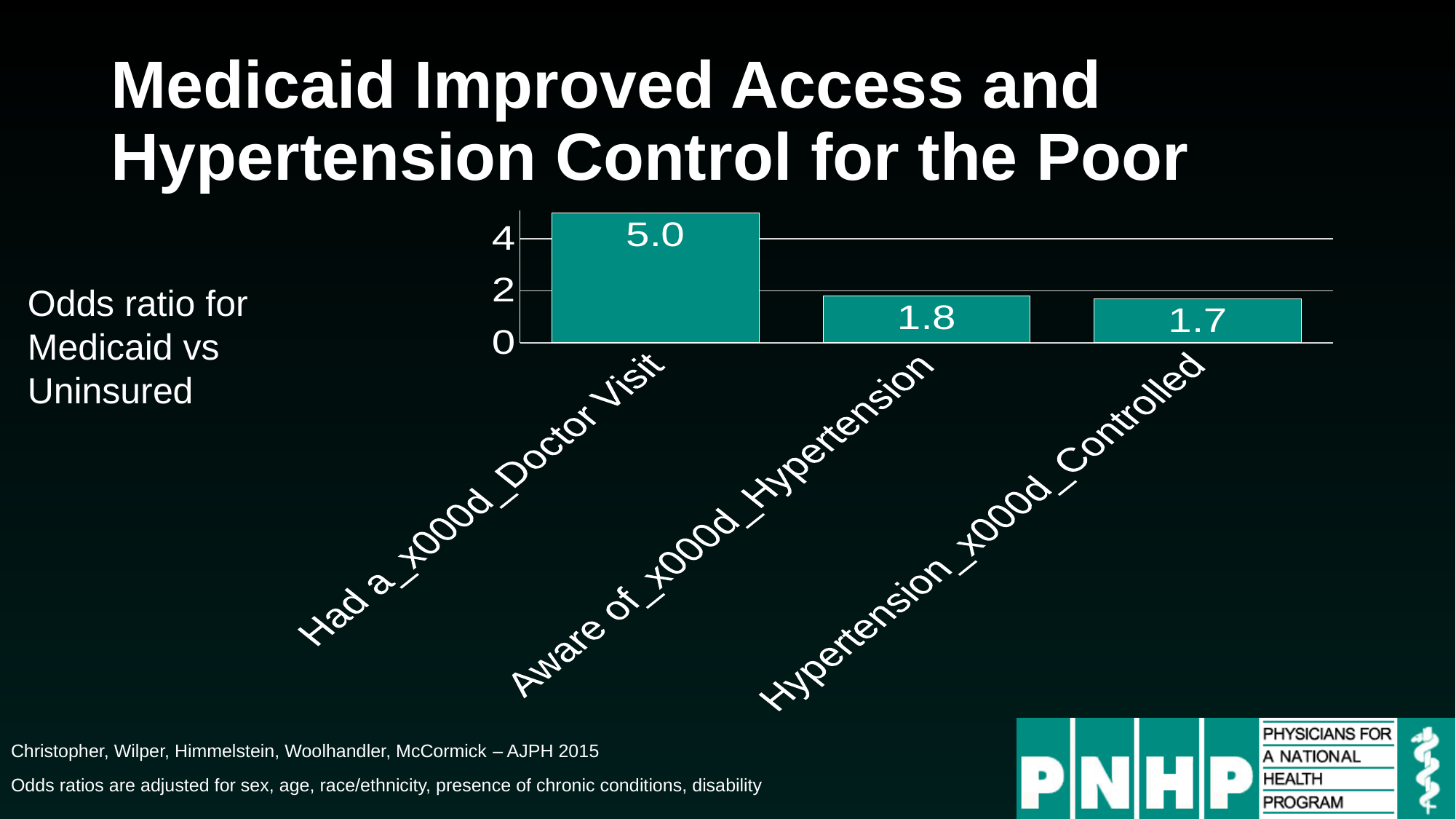
Which category has the highest odds ratio? Had a Doctor Visit What is the difference between the odds ratio for "Aware of Hypertension" and for "Hypertension Controlled"? 0.1 What kind of chart is shown on the slide? Bar chart Which category has the lowest odds ratio? Hypertension Controlled What is the difference between the odds ratio for "Had a Doctor Visit" and for "Aware of Hypertension"? 3.2 What is the odds ratio shown for "Aware of Hypertension"? 1.8 Which is larger, the odds ratio for "Had a Doctor Visit" or for "Hypertension Controlled"? Had a Doctor Visit What is the odds ratio shown for "Hypertension Controlled"? 1.7 Is the value for "Aware of Hypertension" greater or less than 2? less Is the value for "Had a Doctor Visit" greater or less than 4? greater What is the odds ratio shown for "Had a Doctor Visit"? 5.0 How many categories are plotted in the chart? 3